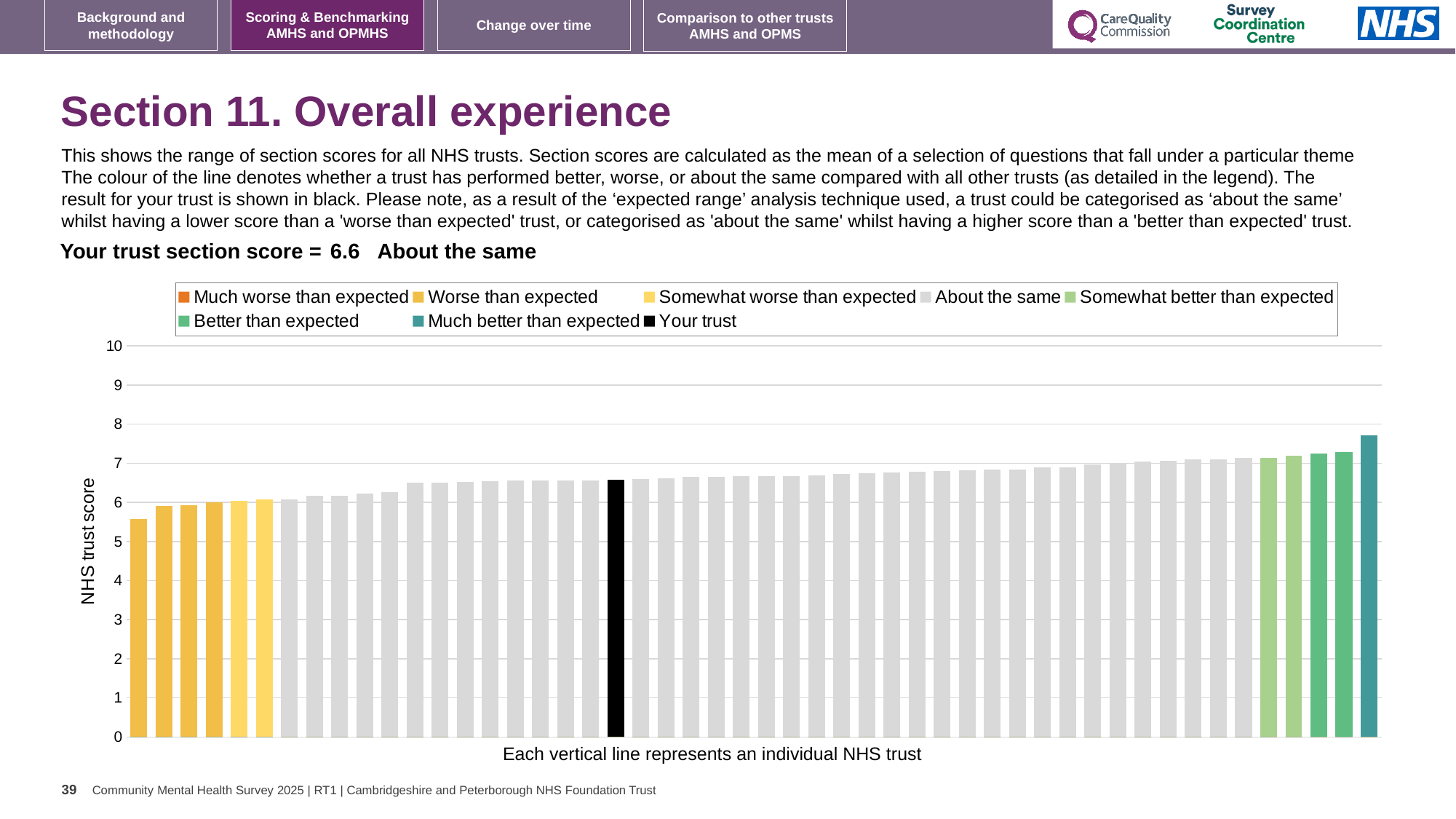
What is the section score for your trust shown on the slide? 6.6 Is the value of the highest bar greater or less than 7? greater Is the value for your trust (the black bar) greater or less than 6? greater Is the value of the highest bar greater or less than 8? less Do the trust scores rise or fall from left to right along the x axis? Rise Which performance category is your trust placed in for Section 11? About the same What kind of chart is used to show the NHS trust scores? Bar chart Which legend category does the lowest-scoring trust belong to? Worse than expected Which legend category does the highest-scoring trust belong to? Much better than expected What is the label on the vertical axis of the chart? NHS trust score How many entries does the chart legend list? 8